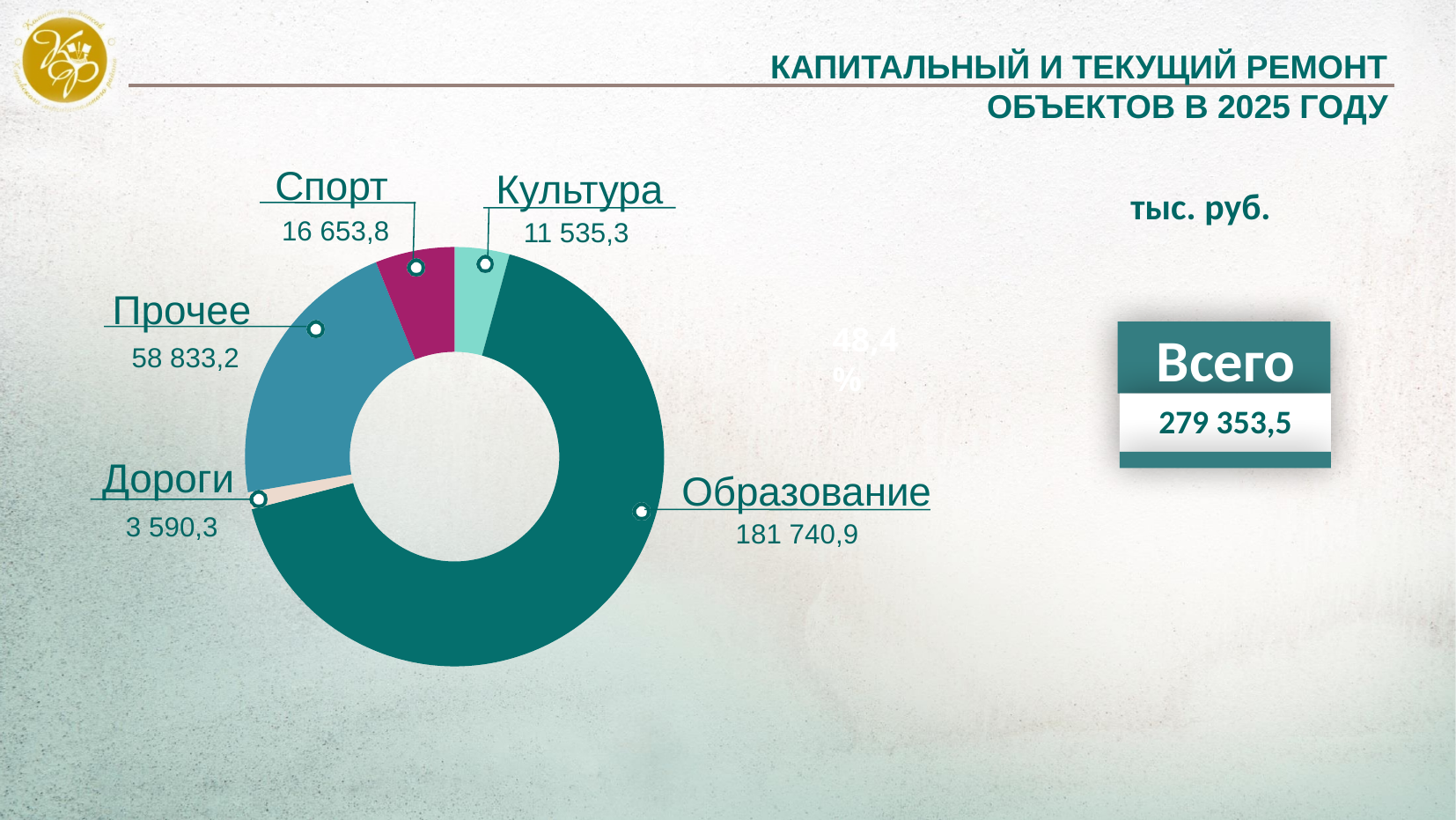
What total value is shown in the 'Всего' box next to the chart? 279 353,5 What is the difference between the values for Образование and Прочее? 122 907,7 Which category has the smallest value? Дороги What is the value for Дороги? 3 590,3 How many categories are shown in the chart? 5 What kind of chart is shown on the slide? Doughnut chart What is the value for Спорт? 16 653,8 Which is larger, Спорт or Культура? Спорт What is the value for Образование? 181 740,9 What is the value for Прочее? 58 833,2 Which category has the largest value? Образование What is the value for Культура? 11 535,3